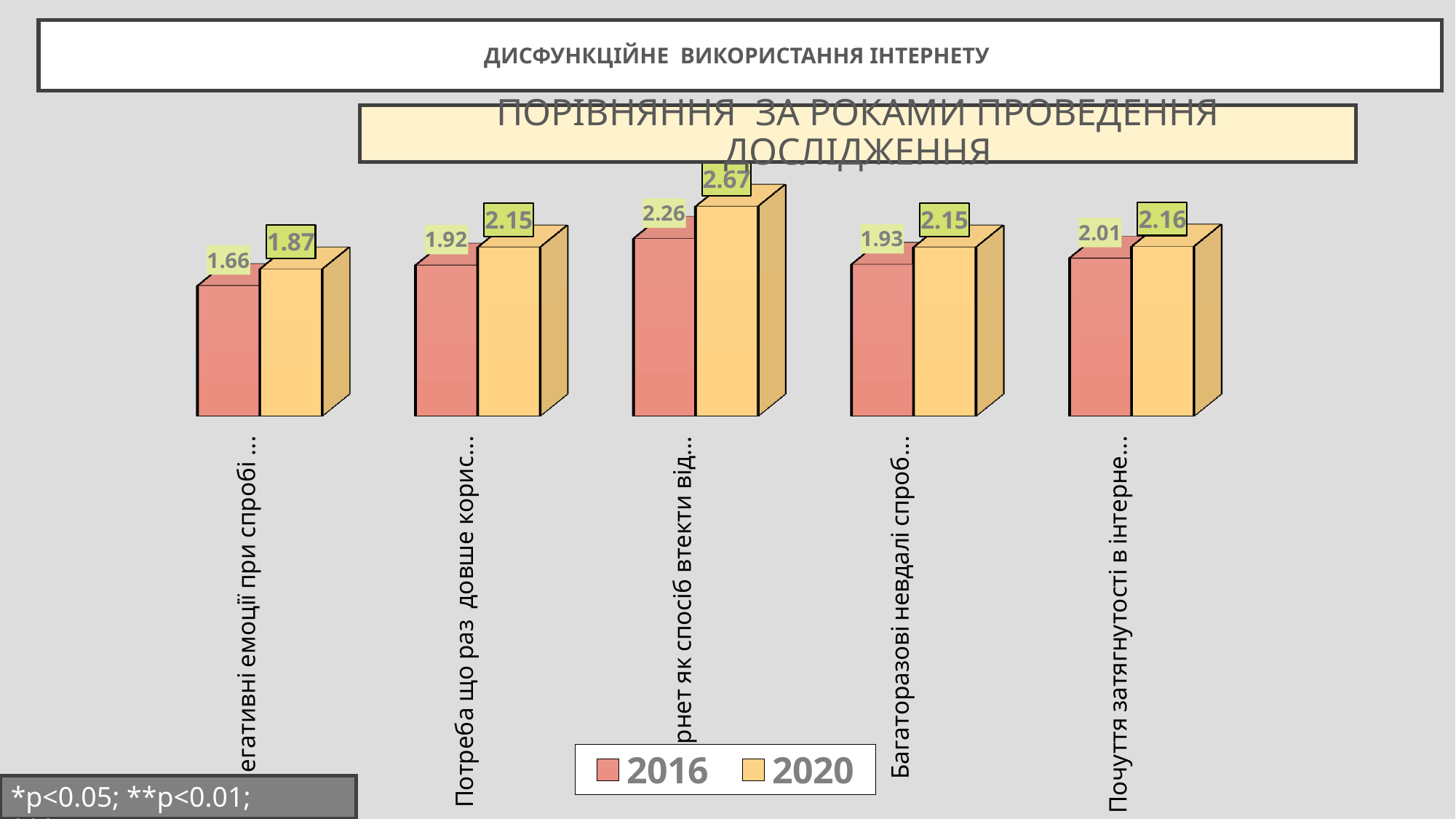
What is the 2020 value for the first (leftmost) category? 1.87 Which category has the highest 2020 value? the third (middle) category, '...рнет як спосіб втекти від...' What is the 2020 value for the category labelled 'Потреба що раз довше корис...'? 2.15 What is the 2016 value for the first (leftmost) category? 1.66 What kind of chart is shown on the slide? bar chart What is the difference between the 2020 and 2016 values for the third (middle) category? 0.41 What is the 2020 value for the category labelled 'Почуття затягнутості в інтерне...'? 2.16 How many series does the legend list? 2 How many categories are plotted along the x axis? 5 What is the 2016 value for the category labelled 'Багаторазові невдалі спроб...'? 1.93 Which category has the lowest 2016 value? the first (leftmost) category, '...егативні емоції при спробі ...' Which series is shown in red in the legend? 2016